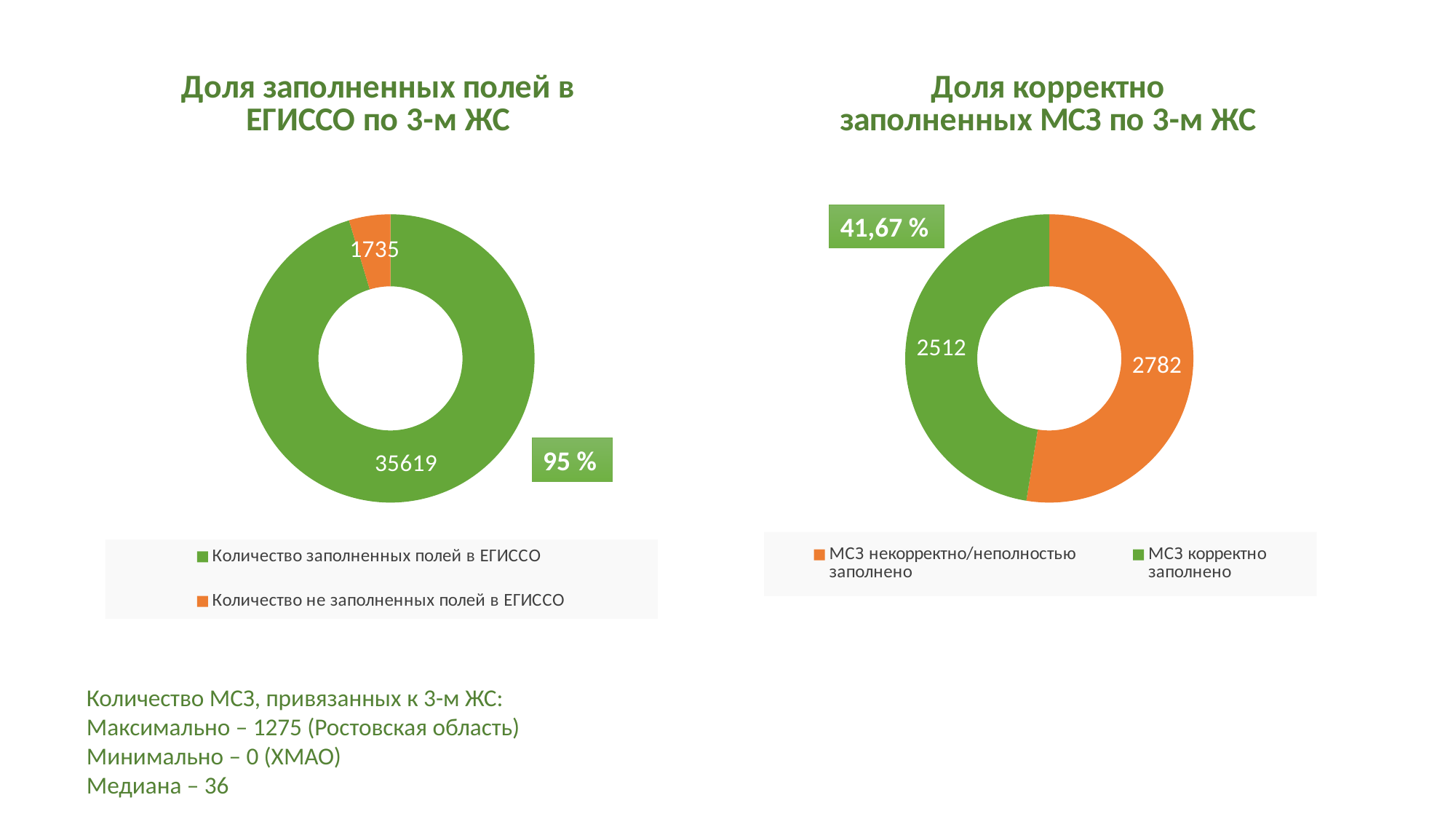
In the chart 'Доля заполненных полей в ЕГИССО по 3-м ЖС', what is the value for 'Количество заполненных полей в ЕГИССО'? 35619 In the chart 'Доля корректно заполненных МСЗ по 3-м ЖС', which category has the larger value? МСЗ некорректно/неполностью заполнено What kind of chart is used for 'Доля заполненных полей в ЕГИССО по 3-м ЖС'? Pie (doughnut) chart In the chart 'Доля заполненных полей в ЕГИССО по 3-м ЖС', what is the difference between the filled and not filled field counts? 33884 In the chart 'Доля заполненных полей в ЕГИССО по 3-м ЖС', what is the total of the two slices? 37354 In the chart 'Доля корректно заполненных МСЗ по 3-м ЖС', what is the difference between the two slice values? 270 In the chart 'Доля корректно заполненных МСЗ по 3-м ЖС', what is the value for 'МСЗ корректно заполнено'? 2512 In the chart 'Доля корректно заполненных МСЗ по 3-м ЖС', what is the total of the two slices? 5294 In the chart 'Доля заполненных полей в ЕГИССО по 3-м ЖС', what is the value for 'Количество не заполненных полей в ЕГИССО'? 1735 How many entries does the legend of the chart 'Доля корректно заполненных МСЗ по 3-м ЖС' list? 2 In the chart 'Доля заполненных полей в ЕГИССО по 3-м ЖС', what share of the whole is shown for the filled fields? 95 % In the chart 'Доля корректно заполненных МСЗ по 3-м ЖС', what is the value for 'МСЗ некорректно/неполностью заполнено'? 2782